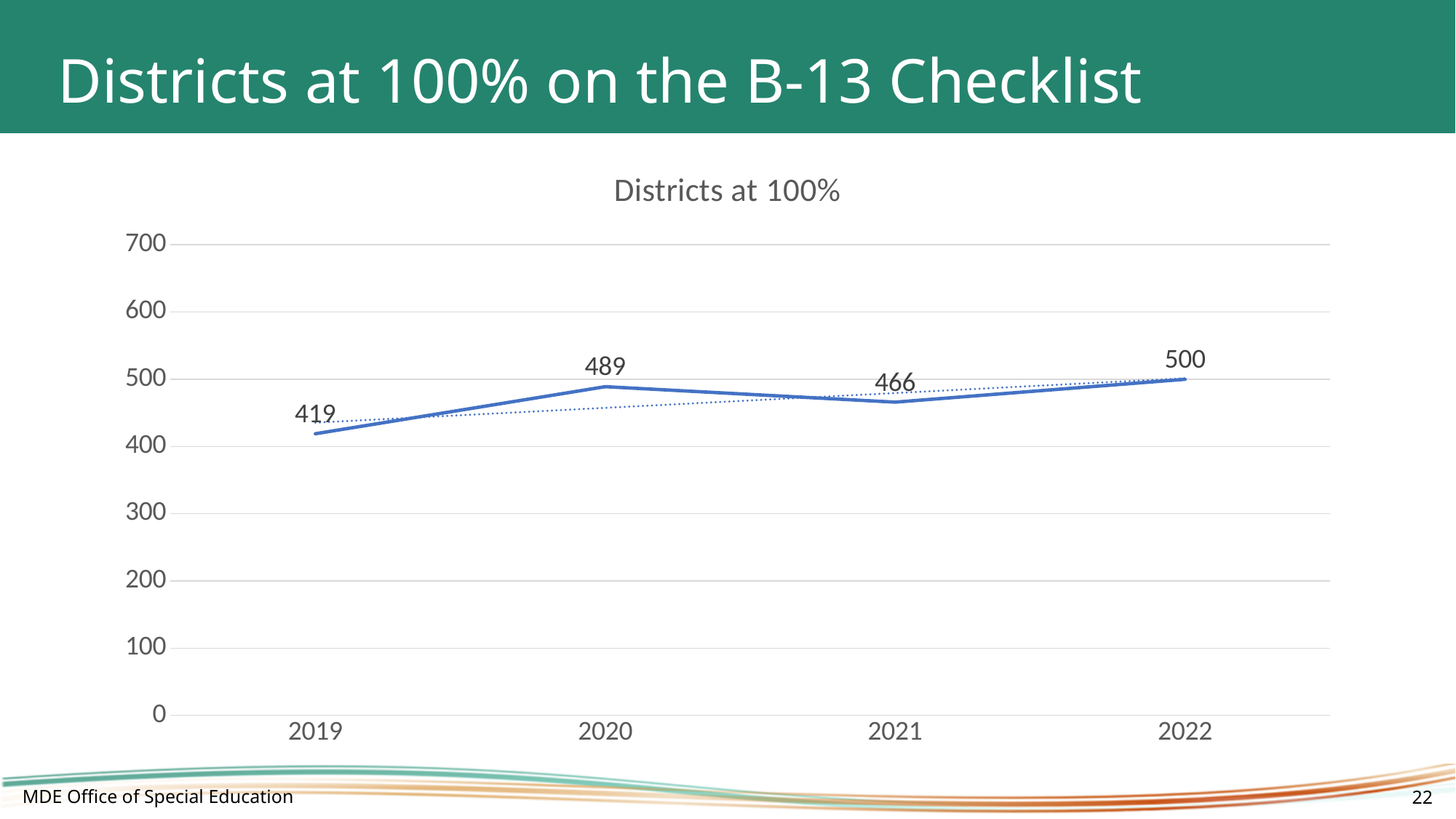
What is the value for 2022? 500 What is the title of the chart? Districts at 100% What is the difference between the values for 2022 and 2021? 34 What is the value for 2021? 466 What is the difference between the values for 2020 and 2019? 70 What is the value for 2019? 419 How many years are plotted on the chart? 4 Which year has the highest value? 2022 What kind of chart is shown? Line chart Which year has the lowest value? 2019 What is the value for 2020? 489 Which is larger, the value for 2020 or the value for 2021? 2020